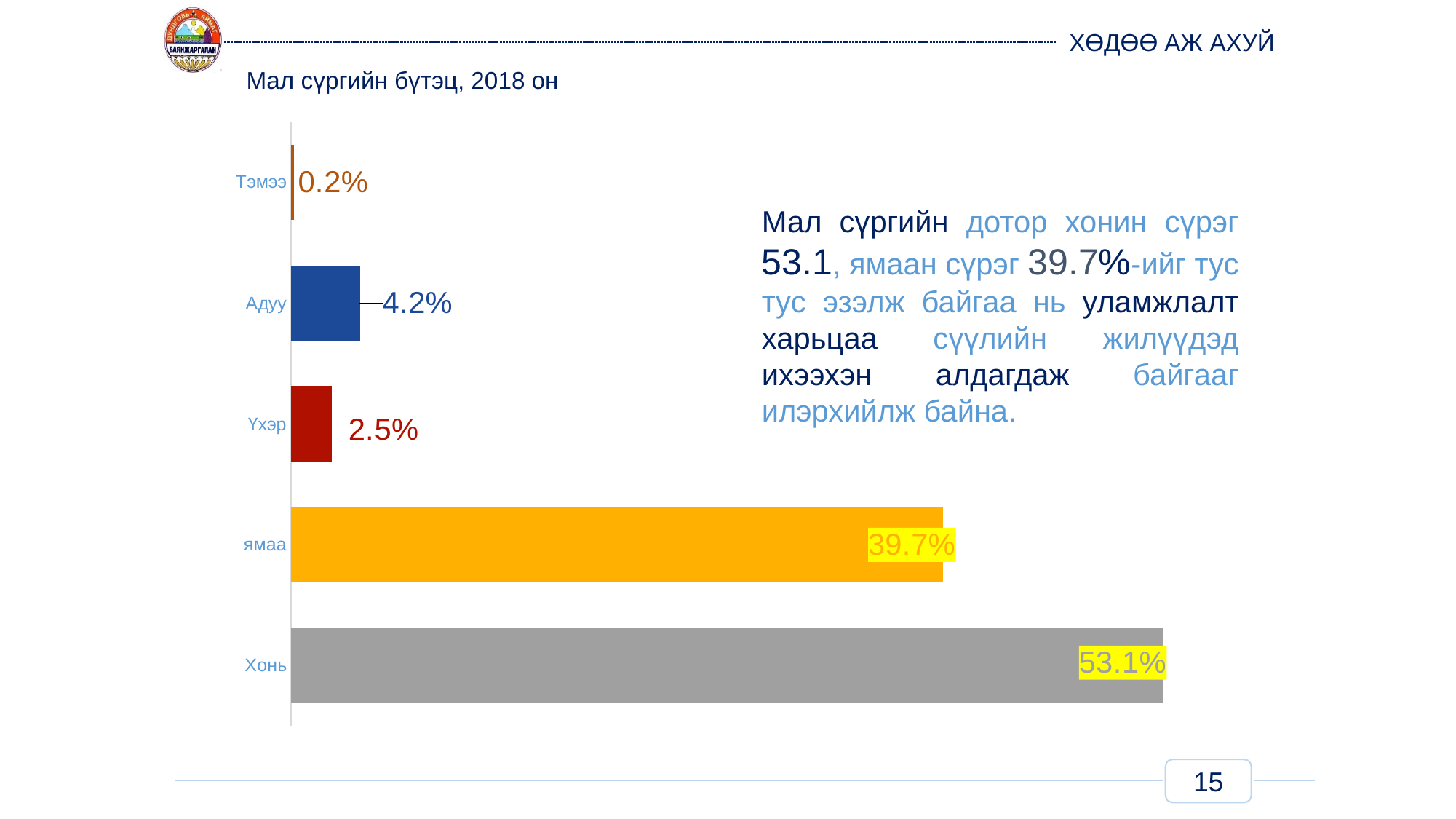
What kind of chart is shown on the slide? Bar chart What is the value for Тэмээ? 0.2% How many categories are shown in the chart? 5 Which category has the highest value? Хонь What is the value for Хонь? 53.1% What is the value for Адуу? 4.2% What is the difference between the values for Хонь and ямаа? 13.4% Which category has the lowest value? Тэмээ What is the title of the chart? Мал сүргийн бүтэц, 2018 он What is the value for Үхэр? 2.5% What is the value for ямаа? 39.7% Which is larger, the value for Адуу or the value for Үхэр? Адуу